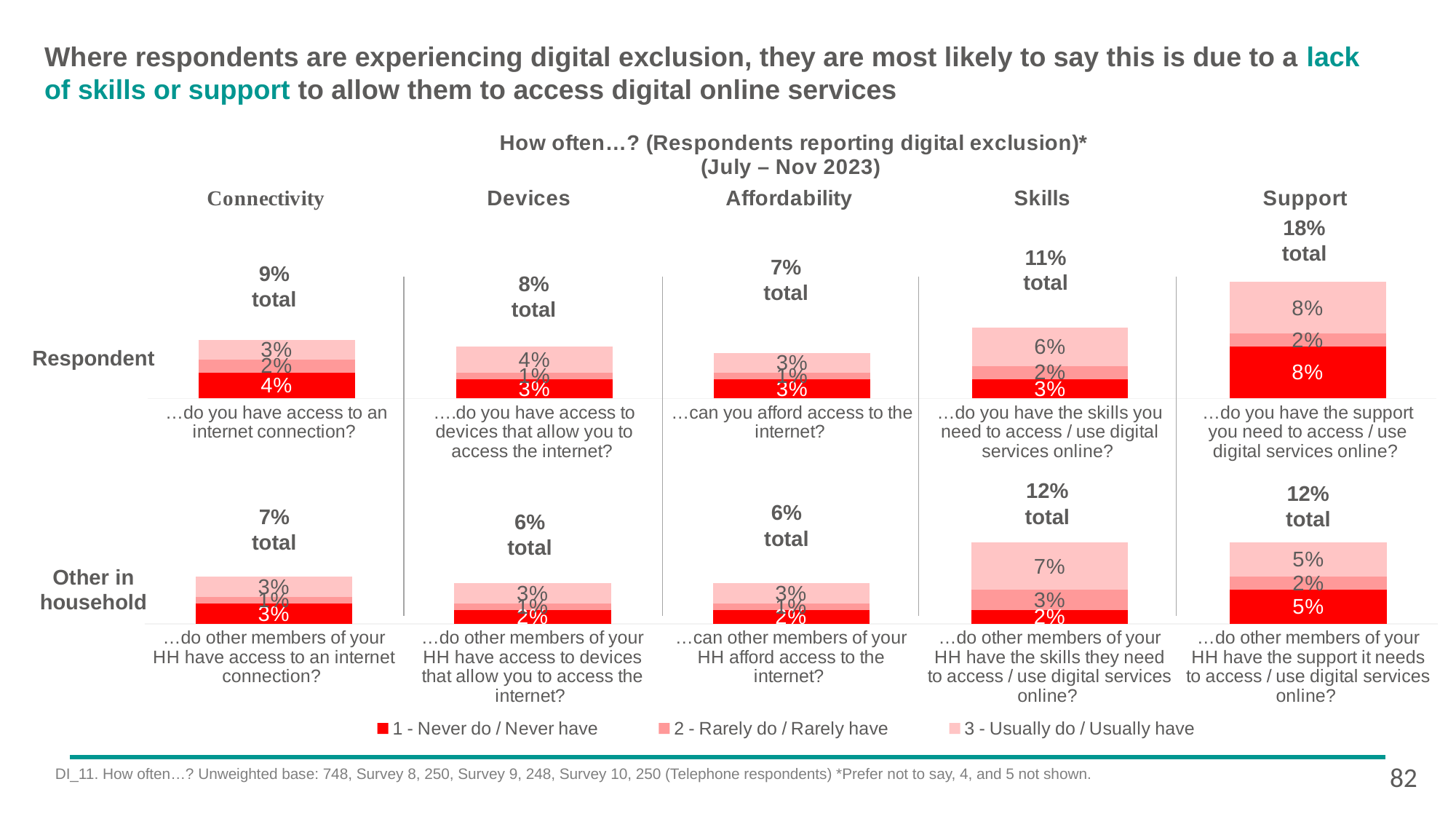
What is the legend label for the darkest red series? 1 - Never do / Never have In the Other in household row, Connectivity chart, what is the value for '1 - Never do / Never have'? 3% What is the difference between the Respondent Support total and the Respondent Connectivity total? 9% How many series does the legend list? 3 In the Respondent row, Support chart, what is the total percentage shown? 18% How many small charts are shown on the slide in total? 10 Which is larger: the Other in household Skills total or the Other in household Devices total? Other in household Skills total In the Respondent row, which of the five charts (Connectivity, Devices, Affordability, Skills, Support) has the highest total? Support In the Respondent row, Skills chart, what is the value for '3 - Usually do / Usually have'? 6% In the Respondent row, Support chart, what is the sum of the '1 - Never do / Never have' and '3 - Usually do / Usually have' segments? 16% What kind of chart is used for each of the ten small charts on the slide? Stacked bar chart In the Respondent row, which of the five charts has the lowest total? Affordability